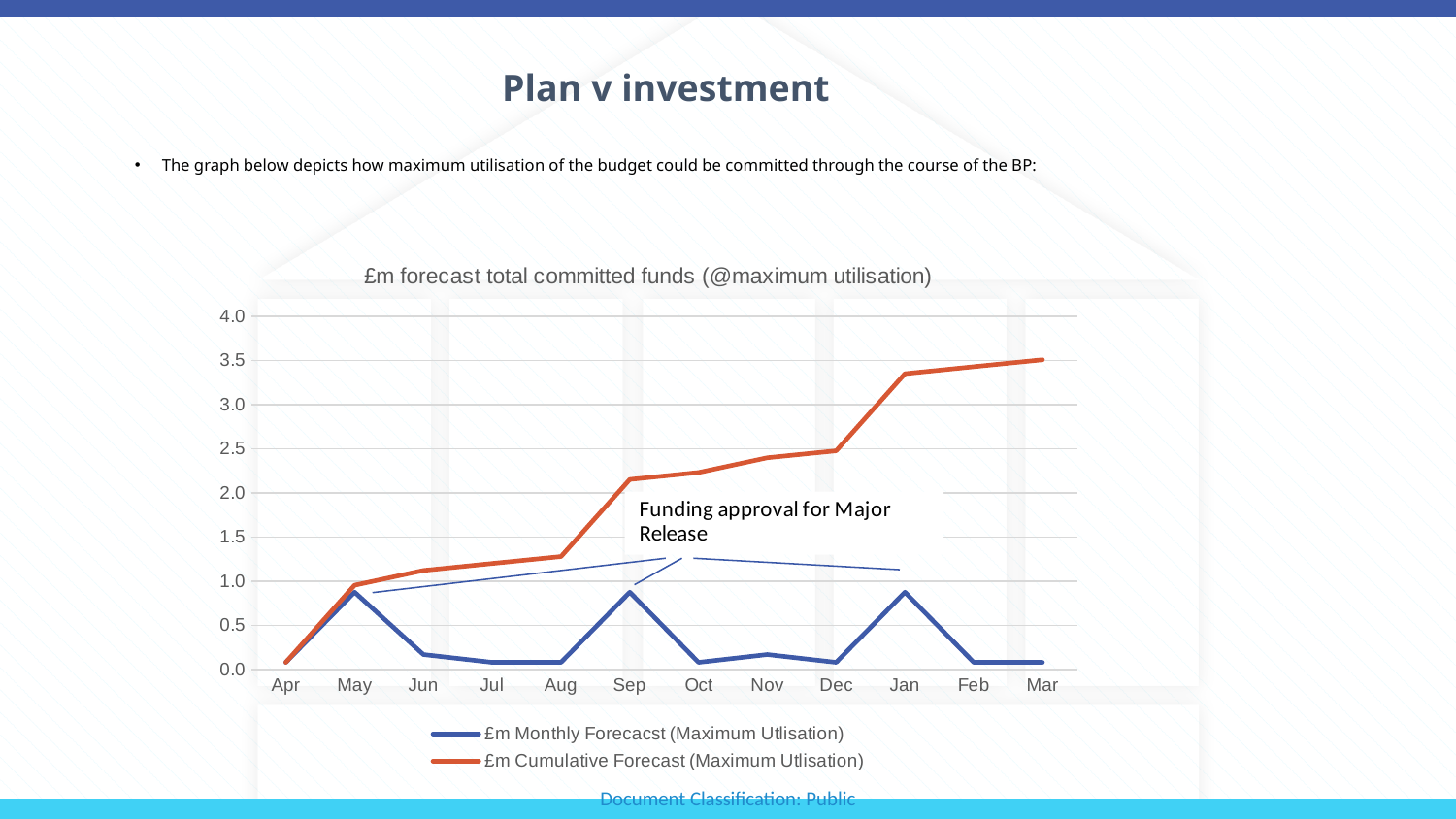
Which is larger for the £m Cumulative Forecast (Maximum Utlisation): the value for Jan or the value for Aug? Jan Is the £m Monthly Forecacst (Maximum Utlisation) value for Jul greater or less than 0.5? less In which month is the £m Cumulative Forecast (Maximum Utlisation) highest? Mar Is the £m Cumulative Forecast (Maximum Utlisation) value for Mar greater or less than 3.0? greater Does the £m Cumulative Forecast (Maximum Utlisation) line rise or fall from Apr to Mar? rise How many months are plotted along the x axis? 12 How many series does the chart legend list? 2 What kind of chart is shown on the slide? line chart Which is larger for the £m Monthly Forecacst (Maximum Utlisation): the value for May or the value for Jun? May In which month is the £m Cumulative Forecast (Maximum Utlisation) lowest? Apr Is the £m Cumulative Forecast (Maximum Utlisation) value for Aug greater or less than 1.5? less What is the title of the chart? £m forecast total committed funds (@maximum utilisation)